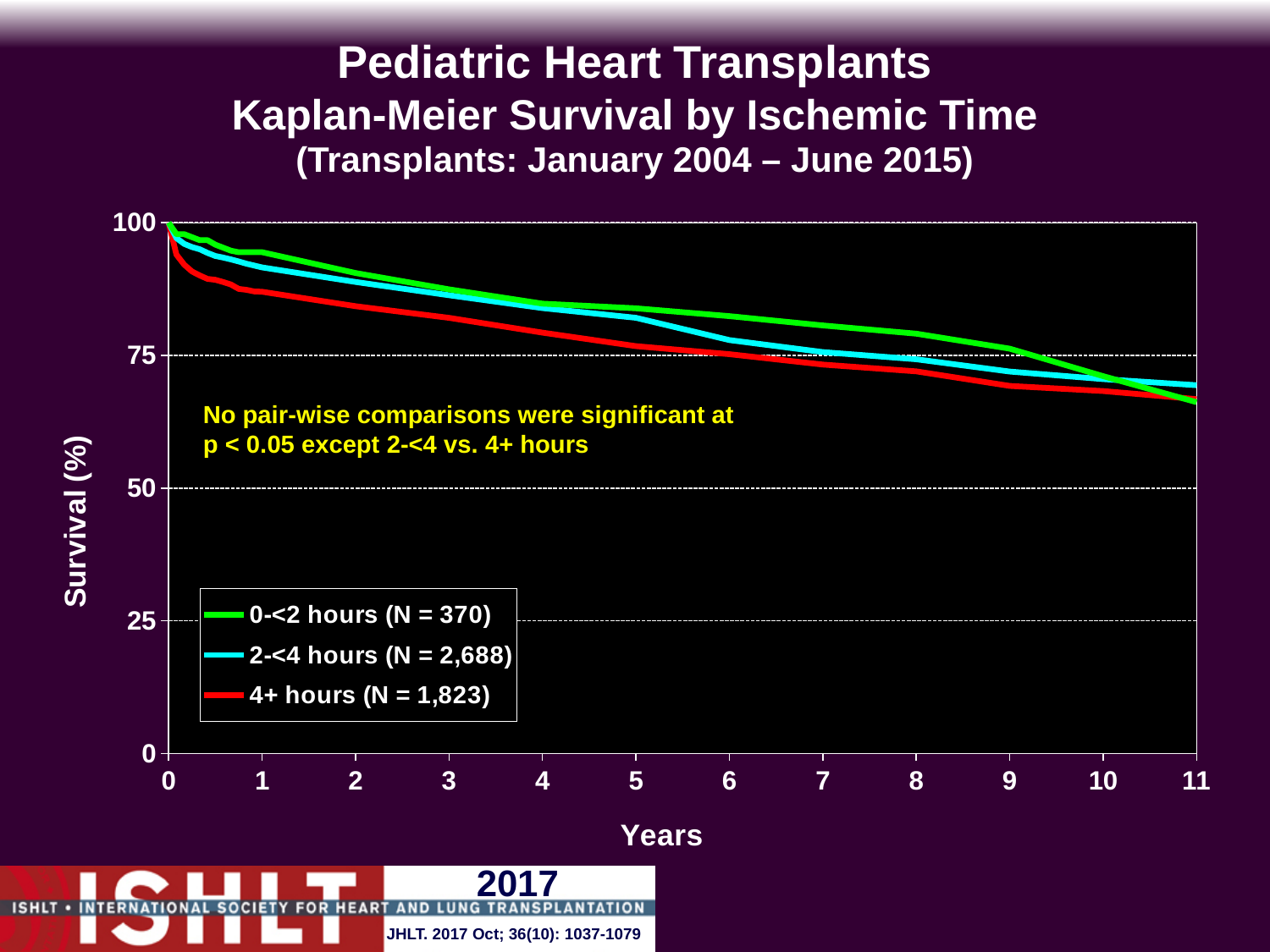
Is the survival for the 0-<2 hours group at year 1 greater or less than 75? greater At year 5, which is higher: survival for the 0-<2 hours group or the 4+ hours group? 0-<2 hours How many series does the legend list? 3 Do the survival curves rise or fall as years increase? fall What kind of chart is shown on the slide? line chart Is the survival for the 4+ hours group at year 1 greater or less than 75? greater At year 3, which group has the lowest survival? 4+ hours Is the survival for the 4+ hours group at year 9 greater or less than 75? less What is the N for the 4+ hours group shown in the legend? 1,823 Which ischemic time group has the largest N according to the legend? 2-<4 hours (N = 2,688) At year 3, which group has the highest survival? 0-<2 hours